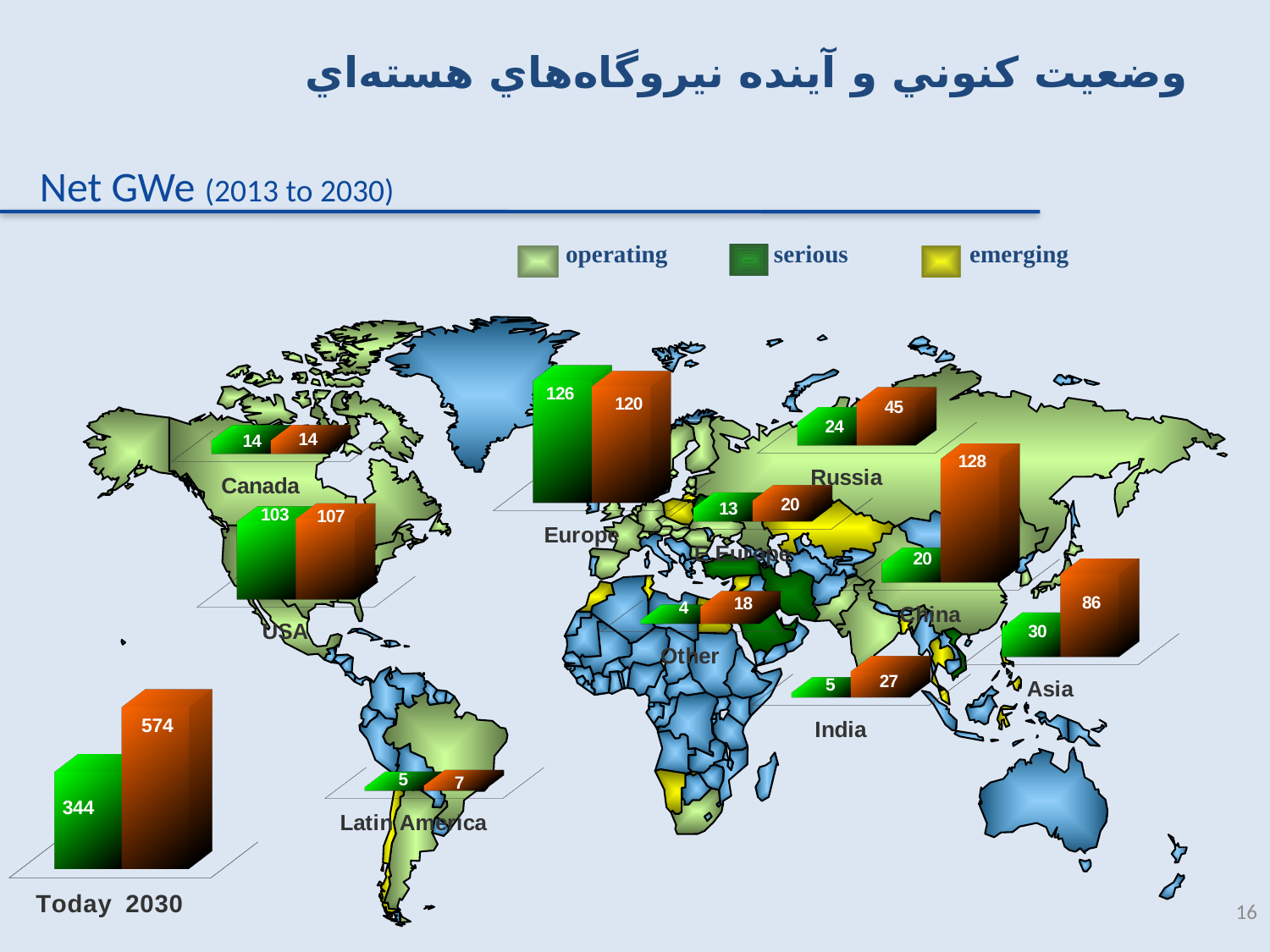
On the world total chart at the bottom left, what is the difference between the 2030 value and the Today value? 230 On the India chart, what is the value for Today? 5 On the China chart, what is the value for 2030? 128 On the Asia chart, what is the difference between the 2030 value and the Today value? 56 On the world total chart at the bottom left, what is the value for 2030? 574 On the Russia chart, what is the value for Today? 24 On the USA chart, what is the value for Today? 103 On the Europe chart, which is larger, the Today value or the 2030 value? Today On the Canada chart, what is the value for 2030? 14 What kind of chart is used for each region on the slide? bar chart How many entries does the map legend at the top list? 3 On the USA chart, what is the value for 2030? 107